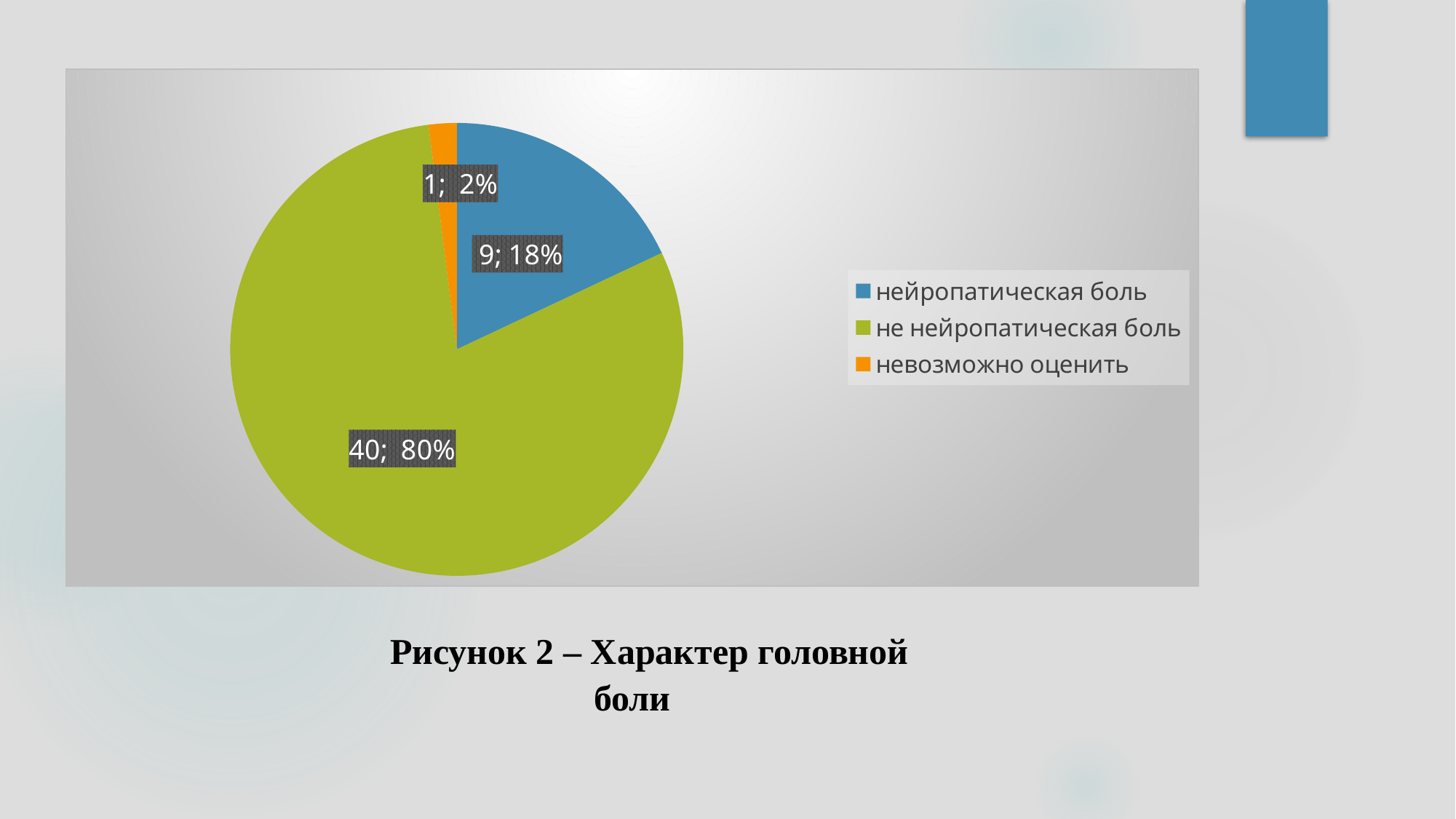
How many entries does the legend list? 3 What share of the pie does "не нейропатическая боль" take? 80% What kind of chart is shown on the slide? pie chart What is the value for "нейропатическая боль"? 9 What is the value for "невозможно оценить"? 1 How many slices does the pie chart have? 3 Which category has the largest slice? не нейропатическая боль Which category has the smallest slice? невозможно оценить What is the difference between the values for "не нейропатическая боль" and "нейропатическая боль"? 31 What is the value for "не нейропатическая боль"? 40 What is the caption of the figure below the chart? Рисунок 2 – Характер головной боли What share of the pie does "нейропатическая боль" take? 18%